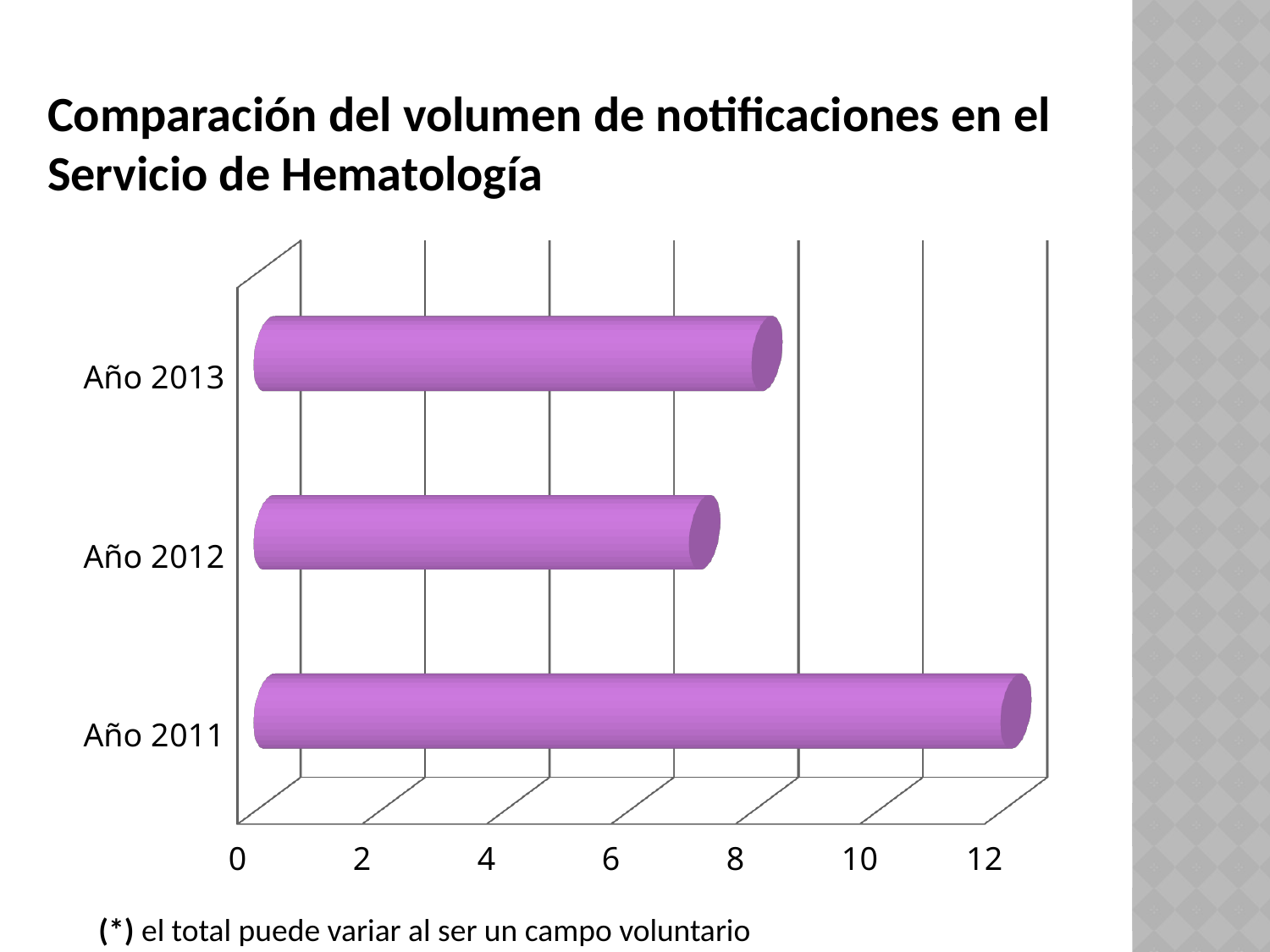
Which year has the highest volume of notifications? Año 2011 How many categories (years) are plotted in the chart? 3 What is the maximum value shown on the horizontal axis of the chart? 12 Is the value for Año 2011 greater or less than 10? greater Which year has the lowest volume of notifications? Año 2012 What kind of chart is shown on the slide? bar chart Which is larger, the value for Año 2011 or the value for Año 2012? Año 2011 What is the title of the chart on the slide? Comparación del volumen de notificaciones en el Servicio de Hematología Which is larger, the value for Año 2013 or the value for Año 2012? Año 2013 Is the value for Año 2013 greater or less than 10? less Is the value for Año 2012 greater or less than 8? less